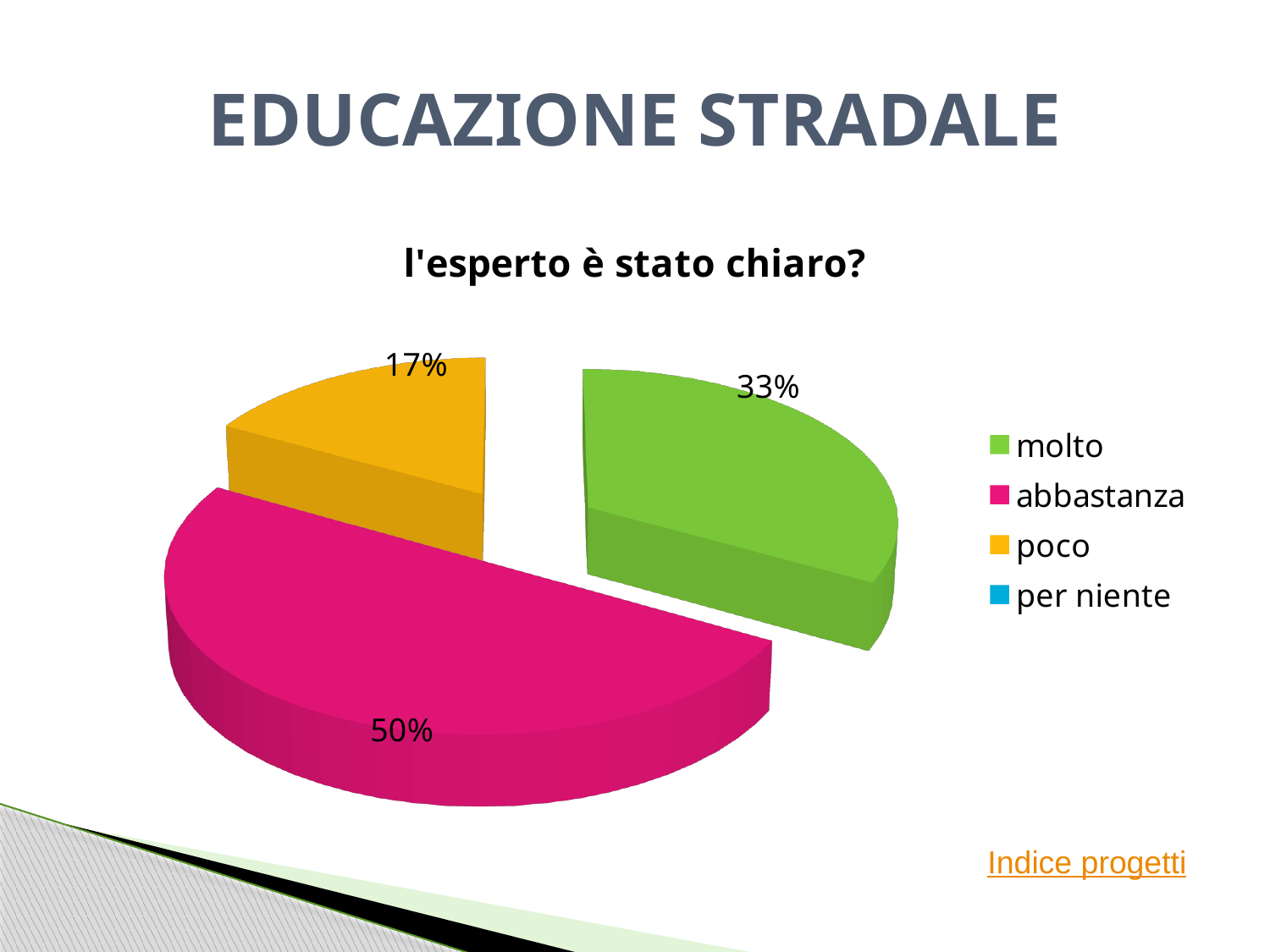
What is the combined share of the 'molto' and 'poco' slices? 50% What colour is the 'abbastanza' slice? pink/magenta Which category with a visible slice has the smallest share? poco What percentage is shown for the 'poco' slice? 17% What is the chart's title? l'esperto è stato chiaro? What kind of chart is shown on the slide? pie chart Which slice is larger, 'molto' or 'poco'? molto What is the difference in percentage points between the 'abbastanza' and 'molto' slices? 17 What percentage is shown for the 'molto' slice? 33% Which category has the largest slice of the pie? abbastanza What percentage is shown for the 'abbastanza' slice? 50% How many entries does the legend list? 4